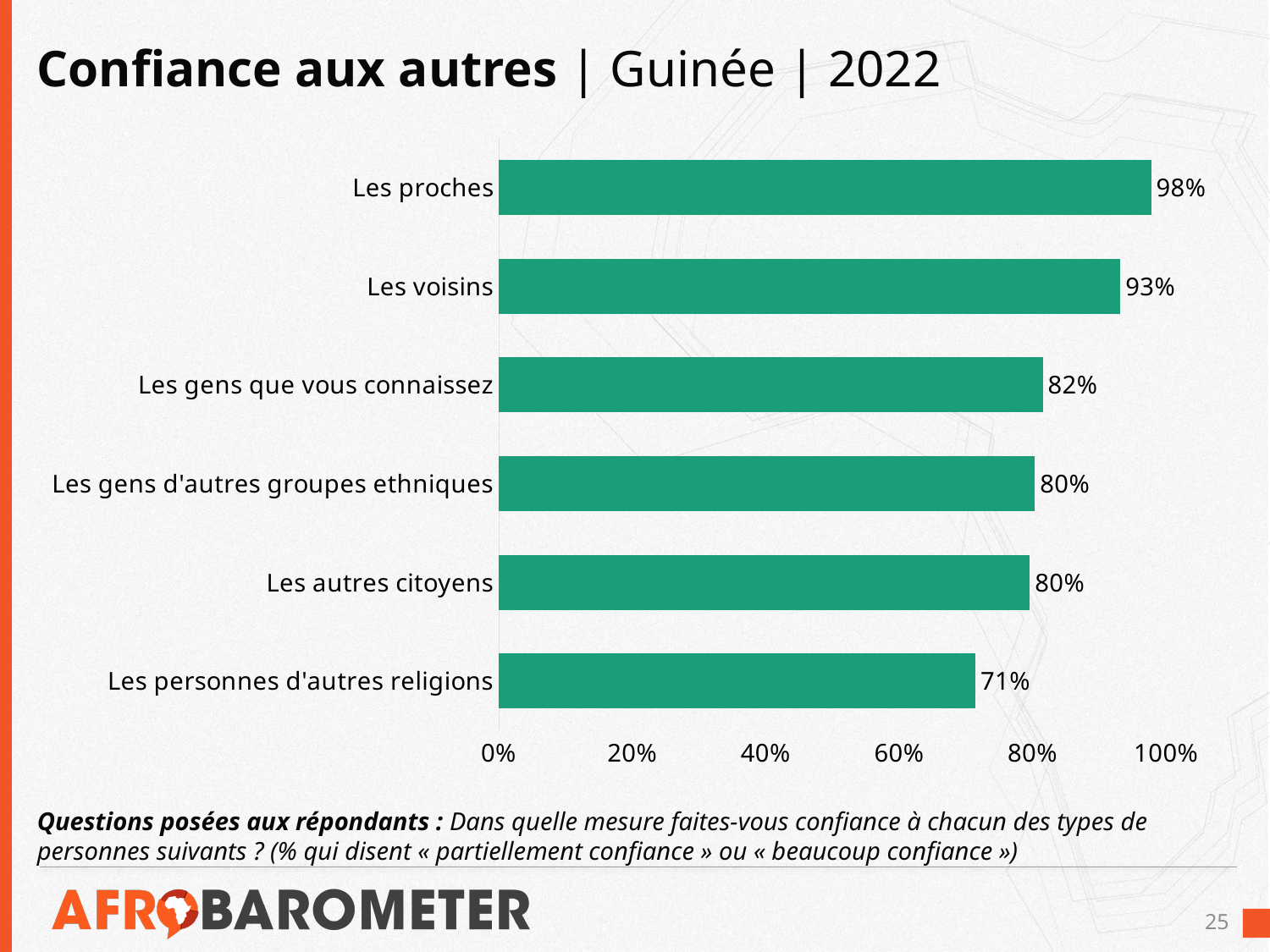
What is the difference between the values for 'Les gens que vous connaissez' and 'Les personnes d'autres religions'? 11% What is the title of the chart on the slide? Confiance aux autres | Guinée | 2022 What value is shown for 'Les gens que vous connaissez'? 82% Which category has the lowest value? Les personnes d'autres religions What is the difference between the values for 'Les proches' and 'Les voisins'? 5% What percentage of respondents say they trust 'Les proches'? 98% How many categories are shown in the chart? 6 What kind of chart is shown on the slide? Bar chart Which category has the highest value? Les proches What value is shown for 'Les personnes d'autres religions'? 71% Is the value for 'Les personnes d'autres religions' greater or less than 80%? less Which is larger: the value for 'Les voisins' or the value for 'Les autres citoyens'? Les voisins